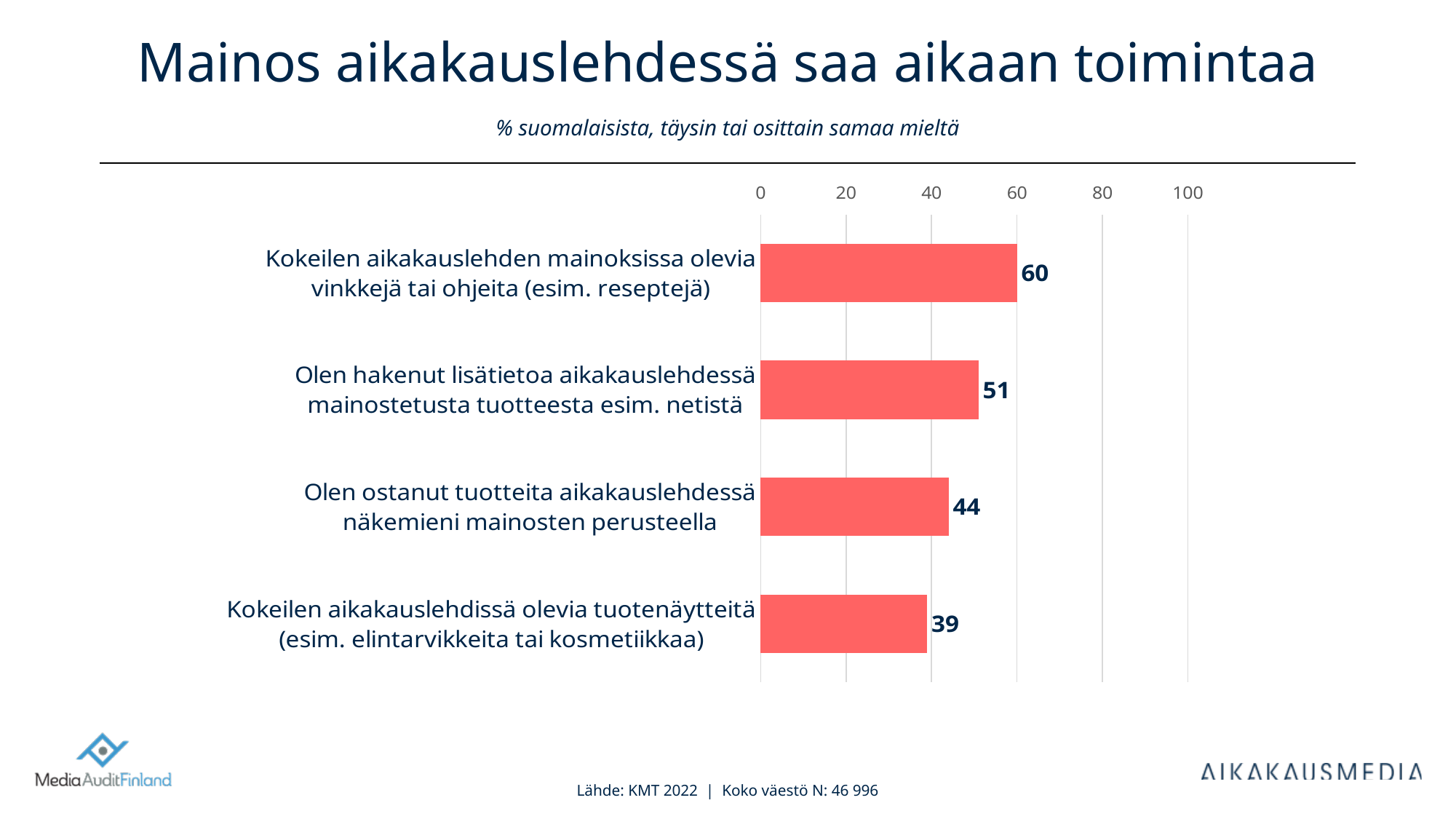
What is the value for "Kokeilen aikakauslehdissä olevia tuotenäytteitä (esim. elintarvikkeita tai kosmetiikkaa)"? 39 What is the value for "Olen hakenut lisätietoa aikakauslehdessä mainostetusta tuotteesta esim. netistä"? 51 How many categories are shown in the chart? 4 What is the title of the slide? Mainos aikakauslehdessä saa aikaan toimintaa Which category has the highest value? Kokeilen aikakauslehden mainoksissa olevia vinkkejä tai ohjeita (esim. reseptejä) What kind of chart is shown on the slide? Bar chart What is the value for "Olen ostanut tuotteita aikakauslehdessä näkemieni mainosten perusteella"? 44 Which is larger: the value for "Olen ostanut tuotteita aikakauslehdessä näkemieni mainosten perusteella" or for "Kokeilen aikakauslehdissä olevia tuotenäytteitä (esim. elintarvikkeita tai kosmetiikkaa)"? Olen ostanut tuotteita aikakauslehdessä näkemieni mainosten perusteella What is the difference between "Olen hakenut lisätietoa aikakauslehdessä mainostetusta tuotteesta esim. netistä" and "Olen ostanut tuotteita aikakauslehdessä näkemieni mainosten perusteella"? 7 Which category has the lowest value? Kokeilen aikakauslehdissä olevia tuotenäytteitä (esim. elintarvikkeita tai kosmetiikkaa) What is the value for "Kokeilen aikakauslehden mainoksissa olevia vinkkejä tai ohjeita (esim. reseptejä)"? 60 What is the difference between the highest and lowest values shown? 21